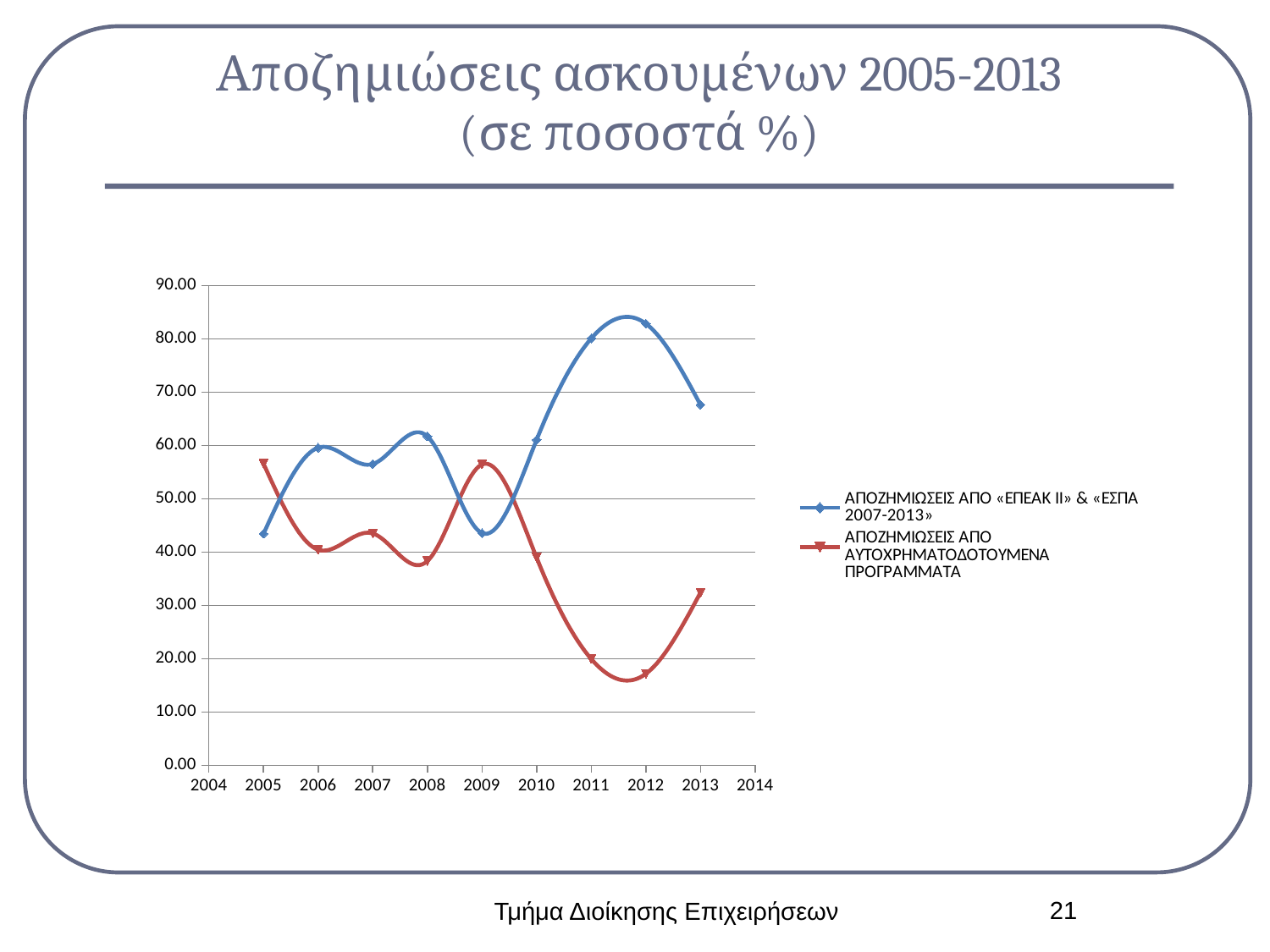
In which year does the series ΑΠΟΖΗΜΙΩΣΕΙΣ ΑΠΟ «ΕΠΕΑΚ II» & «ΕΣΠΑ 2007-2013» reach its highest value? 2012 Is the 2011 value for ΑΠΟΖΗΜΙΩΣΕΙΣ ΑΠΟ «ΕΠΕΑΚ II» & «ΕΣΠΑ 2007-2013» greater or less than 70.00? greater In 2005, which series has the larger value: ΑΠΟΖΗΜΙΩΣΕΙΣ ΑΠΟ «ΕΠΕΑΚ II» & «ΕΣΠΑ 2007-2013» or ΑΠΟΖΗΜΙΩΣΕΙΣ ΑΠΟ ΑΥΤΟΧΡΗΜΑΤΟΔΟΤΟΥΜΕΝΑ ΠΡΟΓΡΑΜΜΑΤΑ? ΑΠΟΖΗΜΙΩΣΕΙΣ ΑΠΟ ΑΥΤΟΧΡΗΜΑΤΟΔΟΤΟΥΜΕΝΑ ΠΡΟΓΡΑΜΜΑΤΑ In 2010, which series has the larger value: ΑΠΟΖΗΜΙΩΣΕΙΣ ΑΠΟ «ΕΠΕΑΚ II» & «ΕΣΠΑ 2007-2013» or ΑΠΟΖΗΜΙΩΣΕΙΣ ΑΠΟ ΑΥΤΟΧΡΗΜΑΤΟΔΟΤΟΥΜΕΝΑ ΠΡΟΓΡΑΜΜΑΤΑ? ΑΠΟΖΗΜΙΩΣΕΙΣ ΑΠΟ «ΕΠΕΑΚ II» & «ΕΣΠΑ 2007-2013» What kind of chart is shown on the slide? line chart Is the 2005 value for ΑΠΟΖΗΜΙΩΣΕΙΣ ΑΠΟ «ΕΠΕΑΚ II» & «ΕΣΠΑ 2007-2013» greater or less than 50.00? less Between 2009 and 2012, does the series ΑΠΟΖΗΜΙΩΣΕΙΣ ΑΠΟ ΑΥΤΟΧΡΗΜΑΤΟΔΟΤΟΥΜΕΝΑ ΠΡΟΓΡΑΜΜΑΤΑ rise or fall? fall How many years (data points) are plotted for each series? 9 Is the 2012 value for ΑΠΟΖΗΜΙΩΣΕΙΣ ΑΠΟ ΑΥΤΟΧΡΗΜΑΤΟΔΟΤΟΥΜΕΝΑ ΠΡΟΓΡΑΜΜΑΤΑ greater or less than 20.00? less In which year does the series ΑΠΟΖΗΜΙΩΣΕΙΣ ΑΠΟ ΑΥΤΟΧΡΗΜΑΤΟΔΟΤΟΥΜΕΝΑ ΠΡΟΓΡΑΜΜΑΤΑ reach its lowest value? 2012 How many series does the legend list? 2